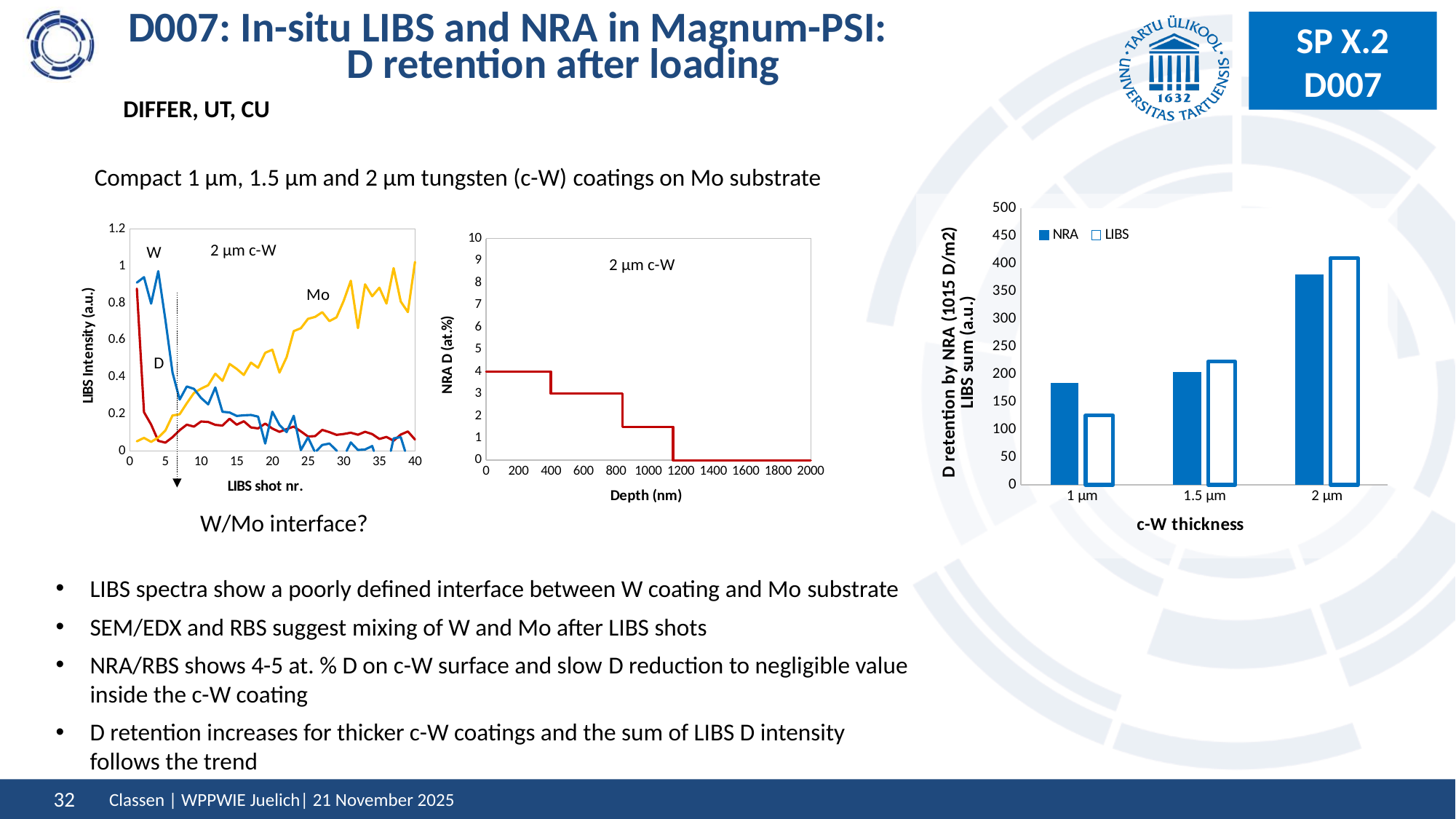
What kind of chart is the chart on the right showing D retention versus c-W thickness? bar chart In the bar chart on the right, how many c-W thickness categories are shown on the x axis? 3 In the left chart of LIBS intensity versus LIBS shot nr., does the Mo curve rise or fall as the shot number increases? rise In the middle chart of NRA D versus depth, what is the NRA D value at a depth of 200 nm? 4 In the bar chart on the right, which c-W thickness has the highest NRA value? 2 µm In the bar chart on the right, is the NRA value for 1 µm greater or less than 200? less In the bar chart on the right, which c-W thickness has the lowest LIBS value? 1 µm In the bar chart on the right, how many series does the legend list? 2 In the bar chart on the right, is the LIBS value for 2 µm greater or less than 400? greater In the middle chart of NRA D versus depth, what is the NRA D value at a depth of 600 nm? 3 In the bar chart on the right, do the NRA values rise or fall as c-W thickness increases? rise In the bar chart on the right, at 1 µm, which series has the larger value, NRA or LIBS? NRA